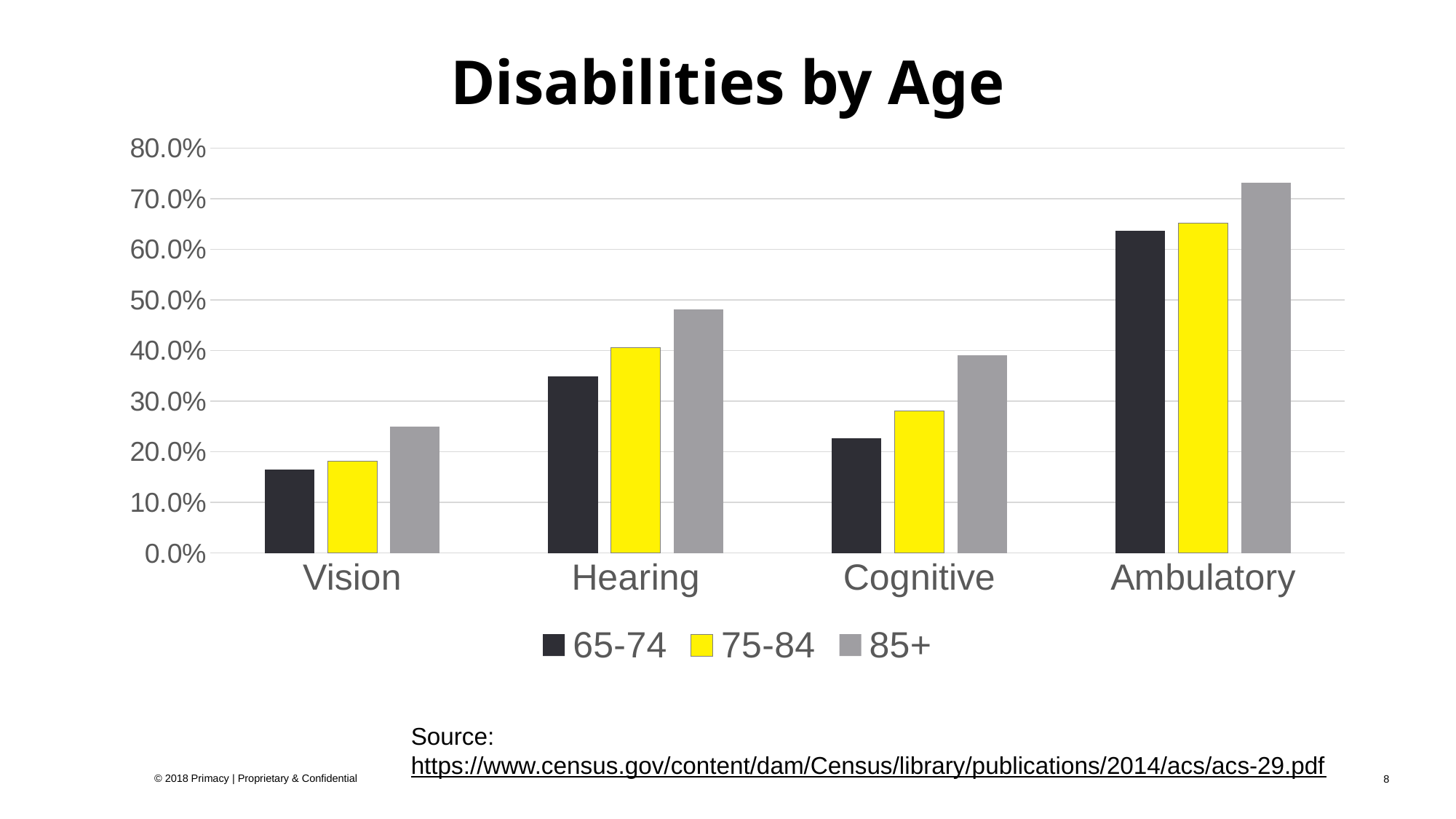
What is the title of the chart? Disabilities by Age How many disability categories are shown on the x axis? 4 Is the value for Ambulatory in the 85+ age group greater or less than 70.0%? greater Is the value for Hearing in the 65-74 age group greater or less than 30.0%? greater Is the value for Vision in the 85+ age group greater or less than 20.0%? greater How many age groups does the legend list? 3 Which disability category has the highest value for the 85+ age group? Ambulatory Within each disability category, do the values rise or fall as the age group increases from 65-74 to 85+? rise What kind of chart is shown on the slide? bar chart For the 85+ age group, which is larger: Hearing or Cognitive? Hearing Which disability category has the lowest value for the 65-74 age group? Vision